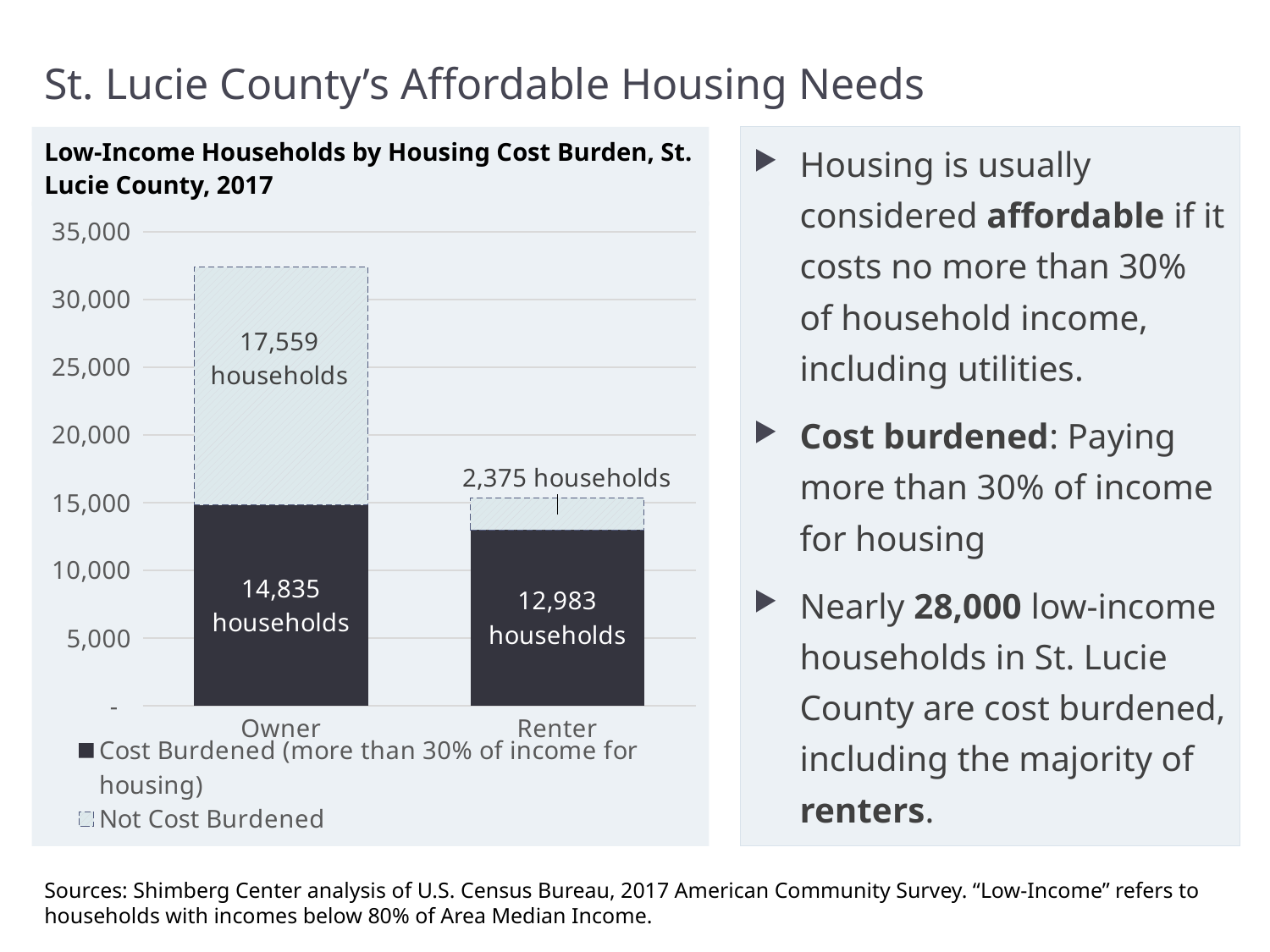
How many not-cost-burdened low-income owner households are shown in the chart? 17,559 households How many series does the chart legend list? 2 What is the total number of low-income owner households shown in the Owner bar? 32,394 households What is the title of the chart? Low-Income Households by Housing Cost Burden, St. Lucie County, 2017 What type of chart is shown on the slide? Stacked bar chart How many cost-burdened low-income owner households are shown in the chart? 14,835 households How many categories are shown on the x axis of the chart? 2 What is the total number of low-income renter households shown in the Renter bar? 15,358 households How many not-cost-burdened low-income renter households are shown in the chart? 2,375 households Which category has the larger number of not-cost-burdened households, Owner or Renter? Owner What is the difference between the number of cost-burdened owner households and cost-burdened renter households? 1,852 households How many cost-burdened low-income renter households are shown in the chart? 12,983 households